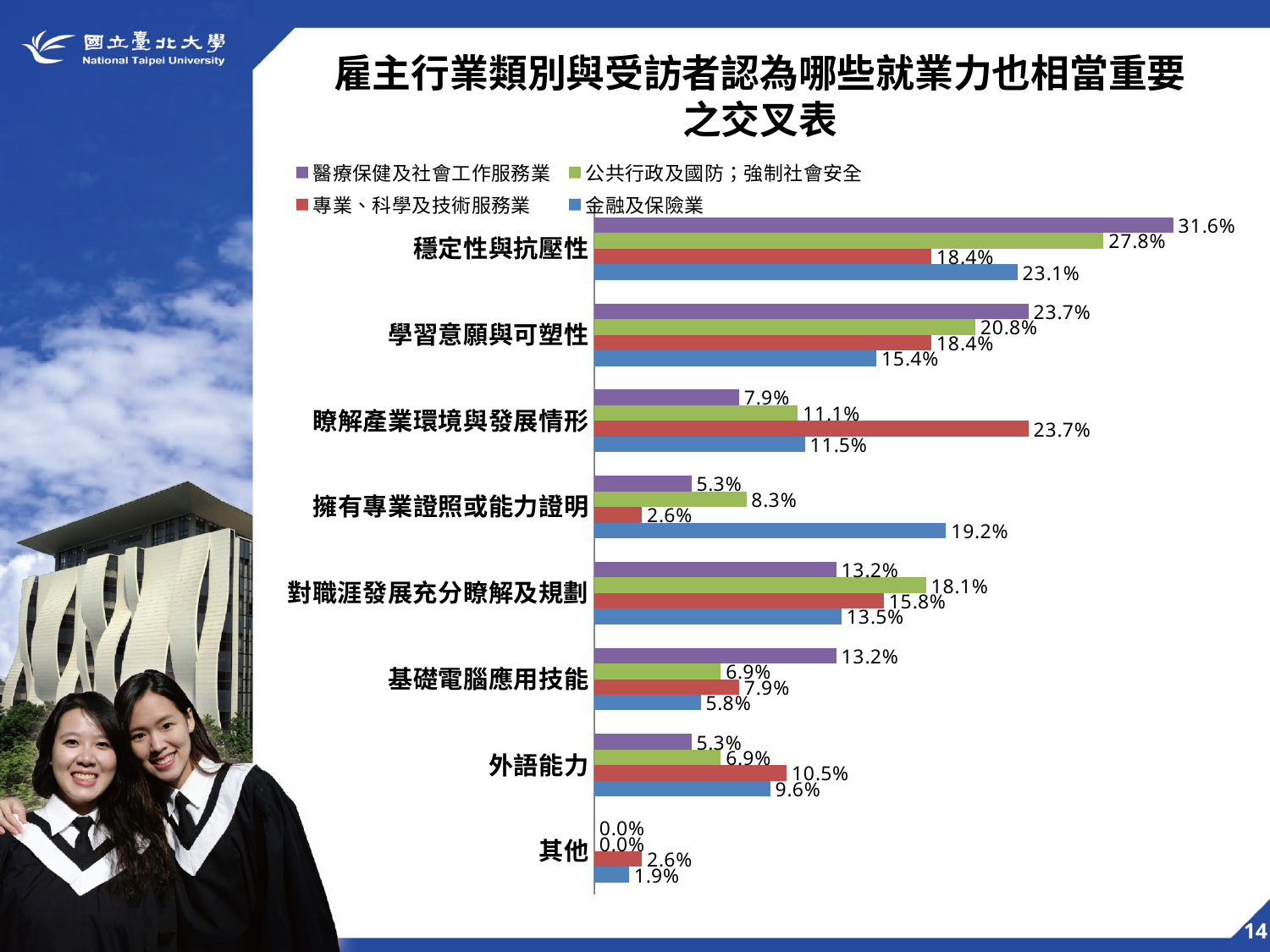
Which category has the lowest value for 金融及保險業? 其他 How many categories are shown on the chart? 8 Which category has the highest value for 公共行政及國防；強制社會安全? 穩定性與抗壓性 Which series is shown in purple in the legend? 醫療保健及社會工作服務業 What is the value for 專業、科學及技術服務業 in the 瞭解產業環境與發展情形 category? 23.7% What is the value for 金融及保險業 in the 擁有專業證照或能力證明 category? 19.2% What is the value for 公共行政及國防；強制社會安全 in the 其他 category? 0.0% What type of chart is shown on the slide? Bar chart What is the difference between 醫療保健及社會工作服務業 and 金融及保險業 in the 穩定性與抗壓性 category? 8.5% How many series does the legend list? 4 What is the value for 醫療保健及社會工作服務業 in the 穩定性與抗壓性 category? 31.6% In the 外語能力 category, which is larger: 專業、科學及技術服務業 or 醫療保健及社會工作服務業? 專業、科學及技術服務業